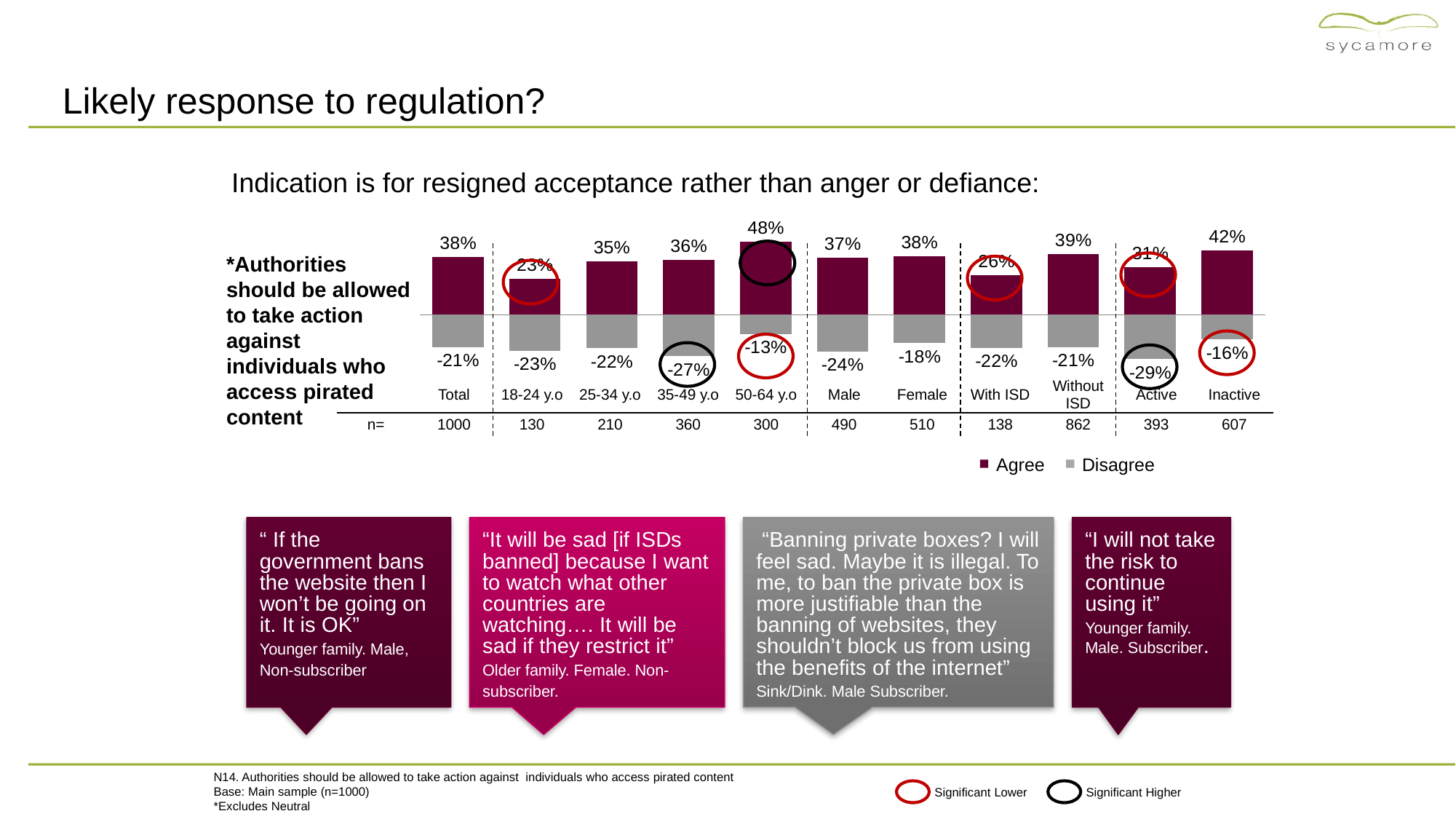
Which category has the lowest Agree value? 18-24 y.o Which category has the highest Agree value? 50-64 y.o How many series does the legend list? 2 What is the Agree value for the 50-64 y.o group? 48% What is the sample size (n=) shown for the Male category? 490 What kind of chart is shown on the slide? Bar chart What is the Disagree value for the Active group? -29% Which has a higher Agree value, Male or Female? Female How many categories are shown along the x axis of the chart? 11 What is the Agree value for the Total category? 38% What is the Disagree value for Female respondents? -18% What is the difference between the Agree values for Inactive and Without ISD? 3 percentage points